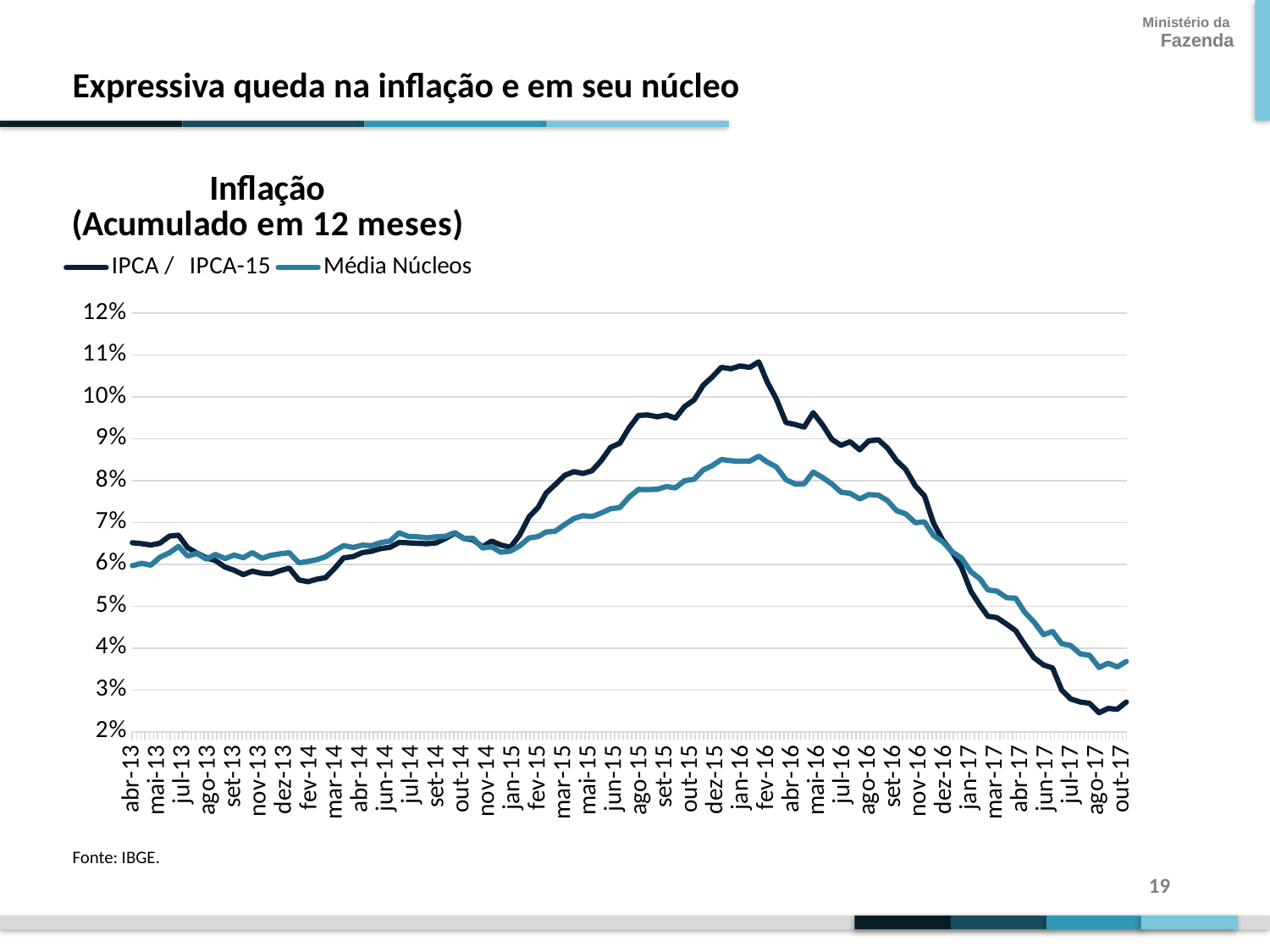
Is the value of the IPCA / IPCA-15 line at fev-16 greater or less than 10%? greater At fev-16, which series has the higher value, IPCA / IPCA-15 or Média Núcleos? IPCA / IPCA-15 Do the values of the IPCA / IPCA-15 line rise or fall between fev-16 and out-17? fall What is the title of the chart? Inflação (Acumulado em 12 meses) Is the value of the Média Núcleos line at out-17 greater or less than 3%? greater What source is cited below the chart? IBGE At out-17, which series has the higher value, IPCA / IPCA-15 or Média Núcleos? Média Núcleos Is the value of the IPCA / IPCA-15 line at out-17 greater or less than 3%? less How many series does the legend list? 2 What kind of chart is shown on the slide? line chart Which series reaches the highest value anywhere on the chart? IPCA / IPCA-15